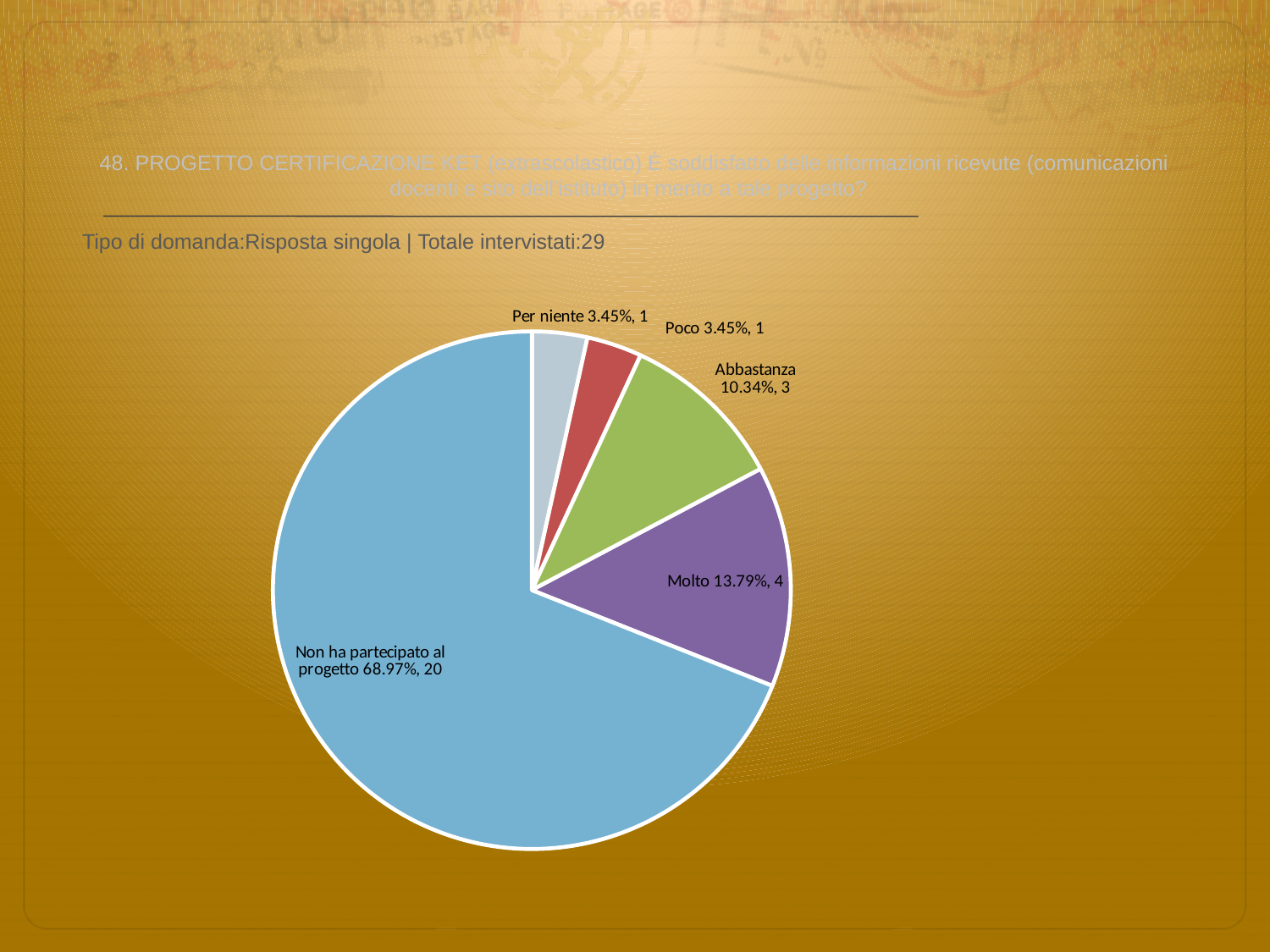
What is the difference in count between 'Molto' and 'Abbastanza'? 1 Which is larger, the 'Molto' slice or the 'Abbastanza' slice? Molto How many respondents answered 'Poco'? 1 What percentage share does the 'Abbastanza' slice have? 10.34% What colour is the 'Molto' slice? purple What percentage share does the 'Non ha partecipato al progetto' slice have? 68.97% How many slices does the pie chart have? 5 What is the total number of respondents across all slices? 29 What kind of chart is shown on the slide? pie chart Which category has the largest slice of the pie? Non ha partecipato al progetto What percentage share does the 'Per niente' slice have? 3.45% How many respondents answered 'Molto'? 4